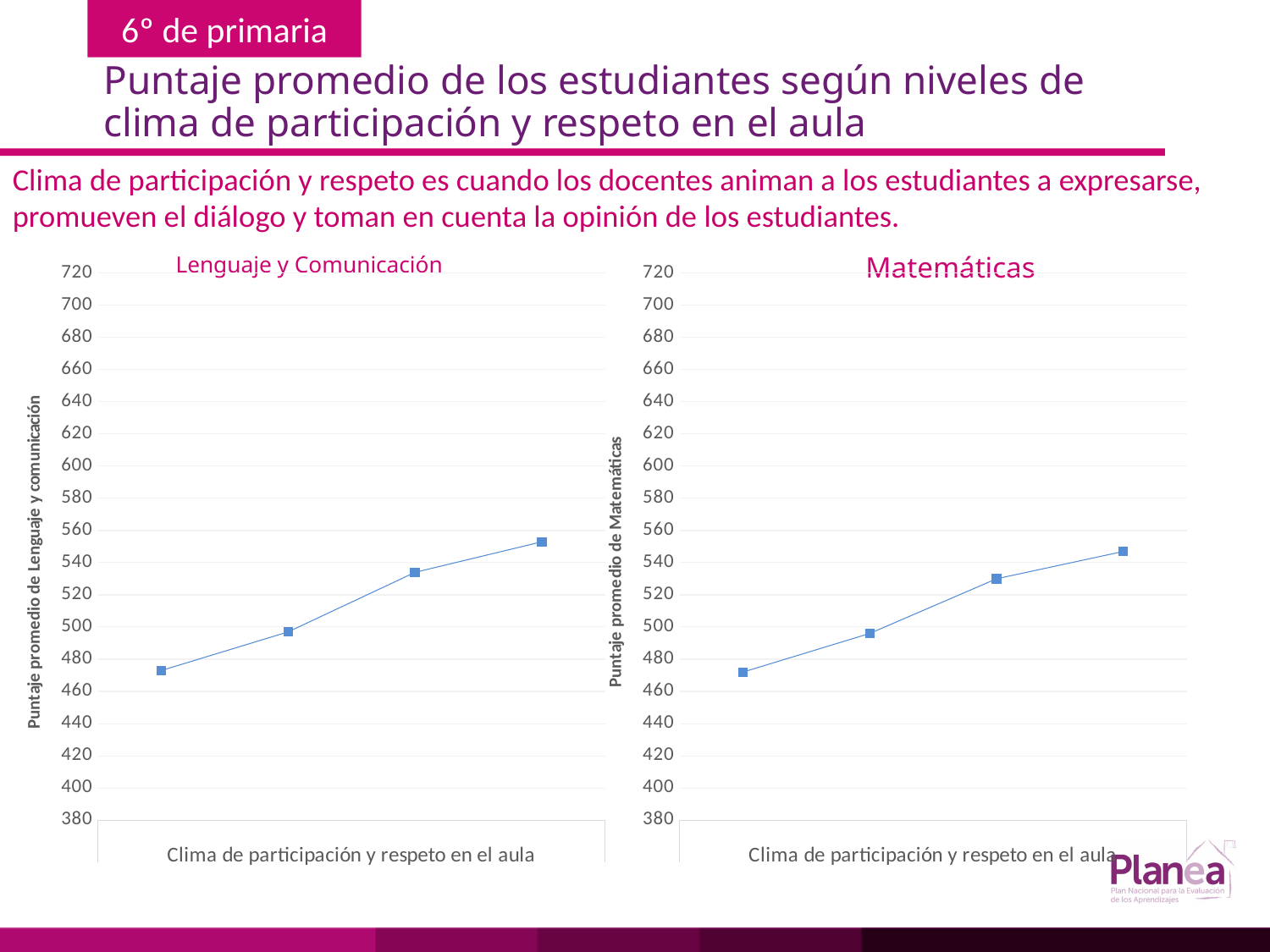
What is the title of the chart on the right side of the slide? Matemáticas How many data points are plotted in the Lenguaje y Comunicación chart? 4 In the Matemáticas chart, which point has the highest value, the leftmost or the rightmost? the rightmost What kind of chart is the Lenguaje y Comunicación chart? line chart In the Matemáticas chart, do the values rise or fall from left to right along the x axis? rise In the Matemáticas chart, is the value of the leftmost point greater or less than 480? less In the Lenguaje y Comunicación chart, is the value of the rightmost point greater or less than 540? greater What is the x-axis label of the Lenguaje y Comunicación chart? Clima de participación y respeto en el aula In the Lenguaje y Comunicación chart, is the value of the leftmost point greater or less than 480? less How many data points are plotted in the Matemáticas chart? 4 In the Lenguaje y Comunicación chart, do the values rise or fall from left to right along the x axis? rise